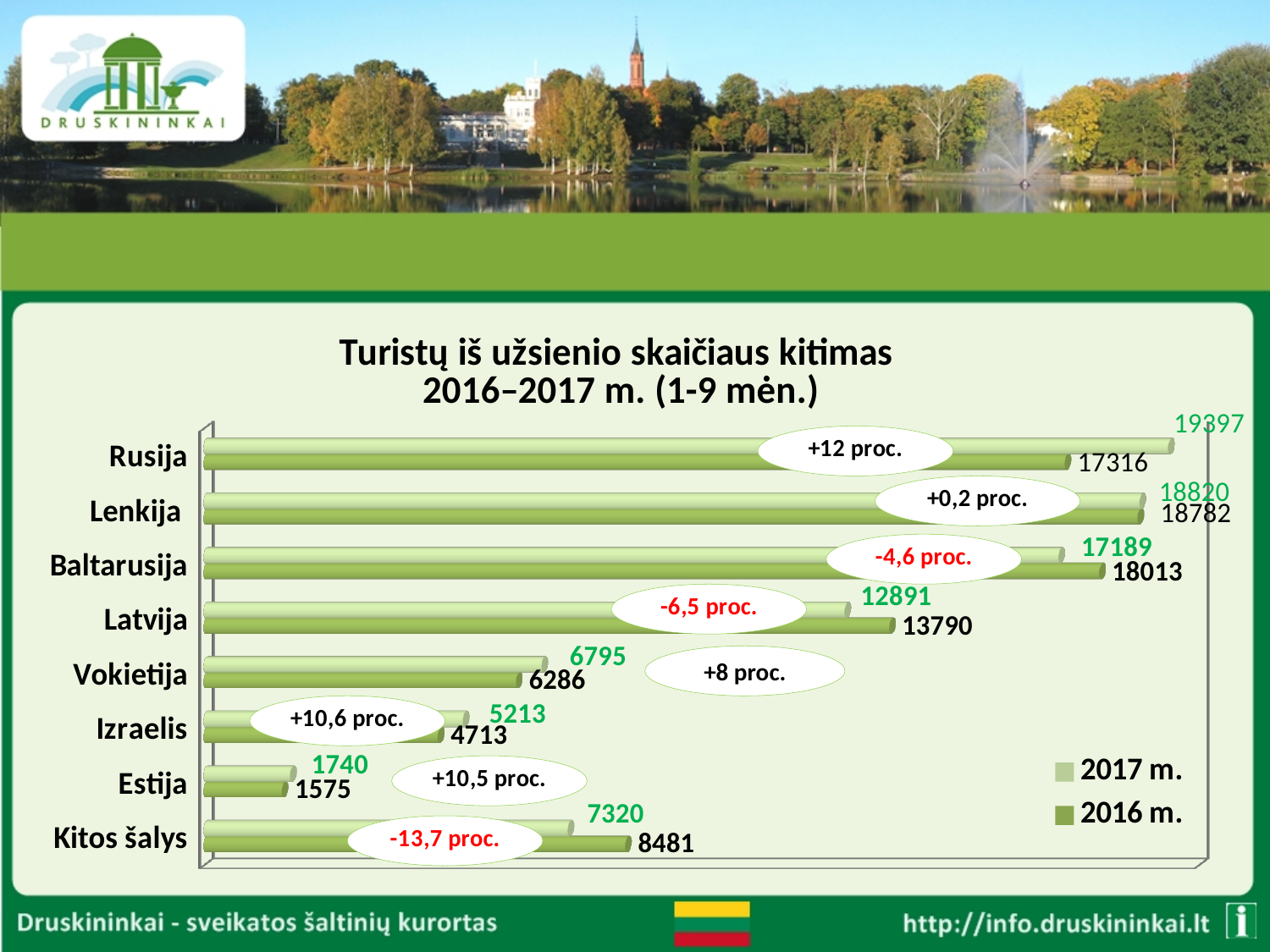
What percentage change is shown for Izraelis? +10,6 proc. Which is larger for Vokietija: the 2017 m. value or the 2016 m. value? 2017 m. What is the 2017 m. value for Kitos šalys? 7320 What is the difference between the 2017 m. and 2016 m. values for Baltarusija? 824 What is the 2017 m. value for Rusija? 19397 How many countries or categories are shown on the chart? 8 What type of chart is shown on the slide? bar chart What is the title of the chart? Turistų iš užsienio skaičiaus kitimas 2016–2017 m. (1-9 mėn.) How many series does the legend list? 2 Which category has the lowest 2016 m. value? Estija Which country has the highest 2017 m. value? Rusija What is the 2016 m. value for Latvija? 13790